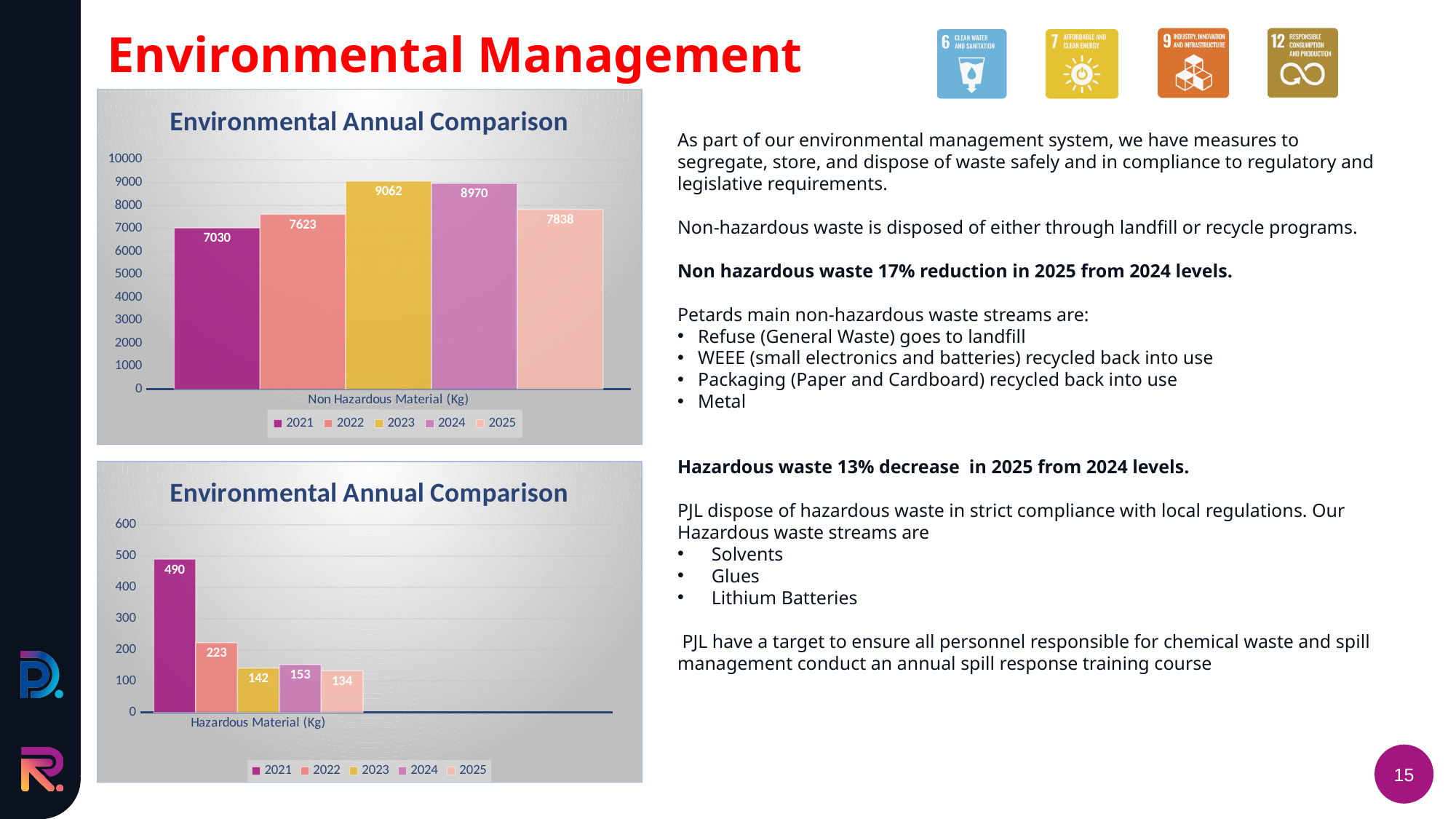
In the bottom chart (Hazardous Material), what is the value for 2021? 490 In the top chart (Non Hazardous Material), which year has the highest value? 2023 How many series does the legend of the bottom chart (Hazardous Material) list? 5 In the top chart (Non Hazardous Material), what is the value for 2025? 7838 In the bottom chart (Hazardous Material), what is the difference between the 2021 and 2022 values? 267 In the bottom chart (Hazardous Material), which year has the lowest value? 2025 What kind of chart is the top chart (Non Hazardous Material)? Bar chart In the top chart (Non Hazardous Material), what is the difference between the 2024 and 2025 values? 1132 In the bottom chart (Hazardous Material), what is the value for 2024? 153 In the top chart (Non Hazardous Material), what is the value for 2023? 9062 In the bottom chart (Hazardous Material), which is larger, the value for 2022 or the value for 2023? 2022 In the top chart (Non Hazardous Material), which year has the lowest value? 2021